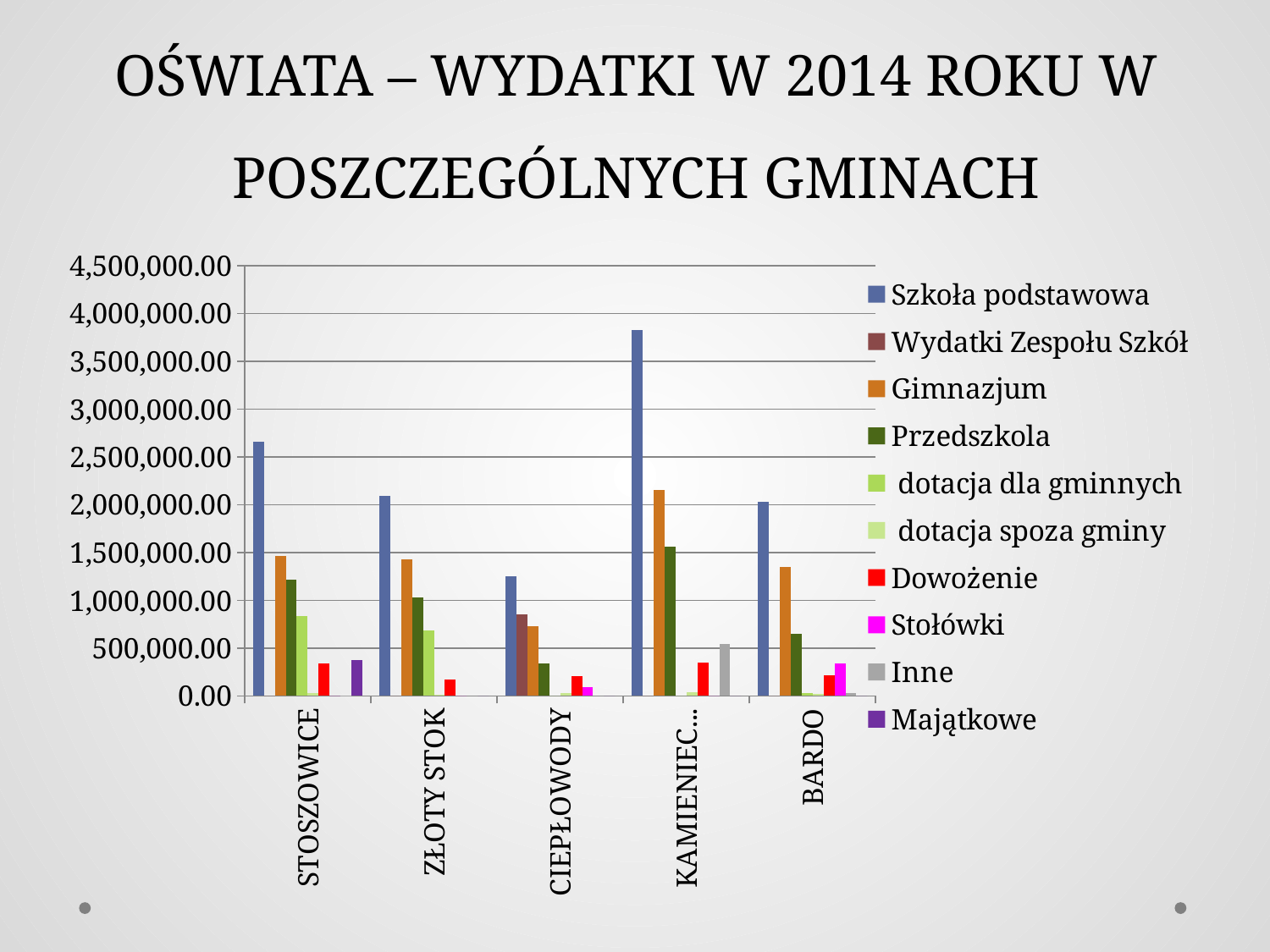
Which is larger: the Gimnazjum value for KAMIENIEC… or for BARDO? KAMIENIEC… Is the value for Dowożenie in ZŁOTY STOK greater or less than 500,000.00? less What kind of chart is shown on the slide? Bar chart How many gminas (categories) are shown on the x axis? 5 Which is larger: the Przedszkola value for STOSZOWICE or for ZŁOTY STOK? STOSZOWICE Which gmina has the lowest value for Gimnazjum? CIEPŁOWODY What colour are the bars for the Dowożenie series? Red Is the value for Szkoła podstawowa in STOSZOWICE greater or less than 2,500,000.00? greater Which gmina has the lowest value for Szkoła podstawowa? CIEPŁOWODY How many series does the legend list? 10 Is the value for Szkoła podstawowa in KAMIENIEC… greater or less than 3,500,000.00? greater Which gmina has the highest value for Szkoła podstawowa? KAMIENIEC…